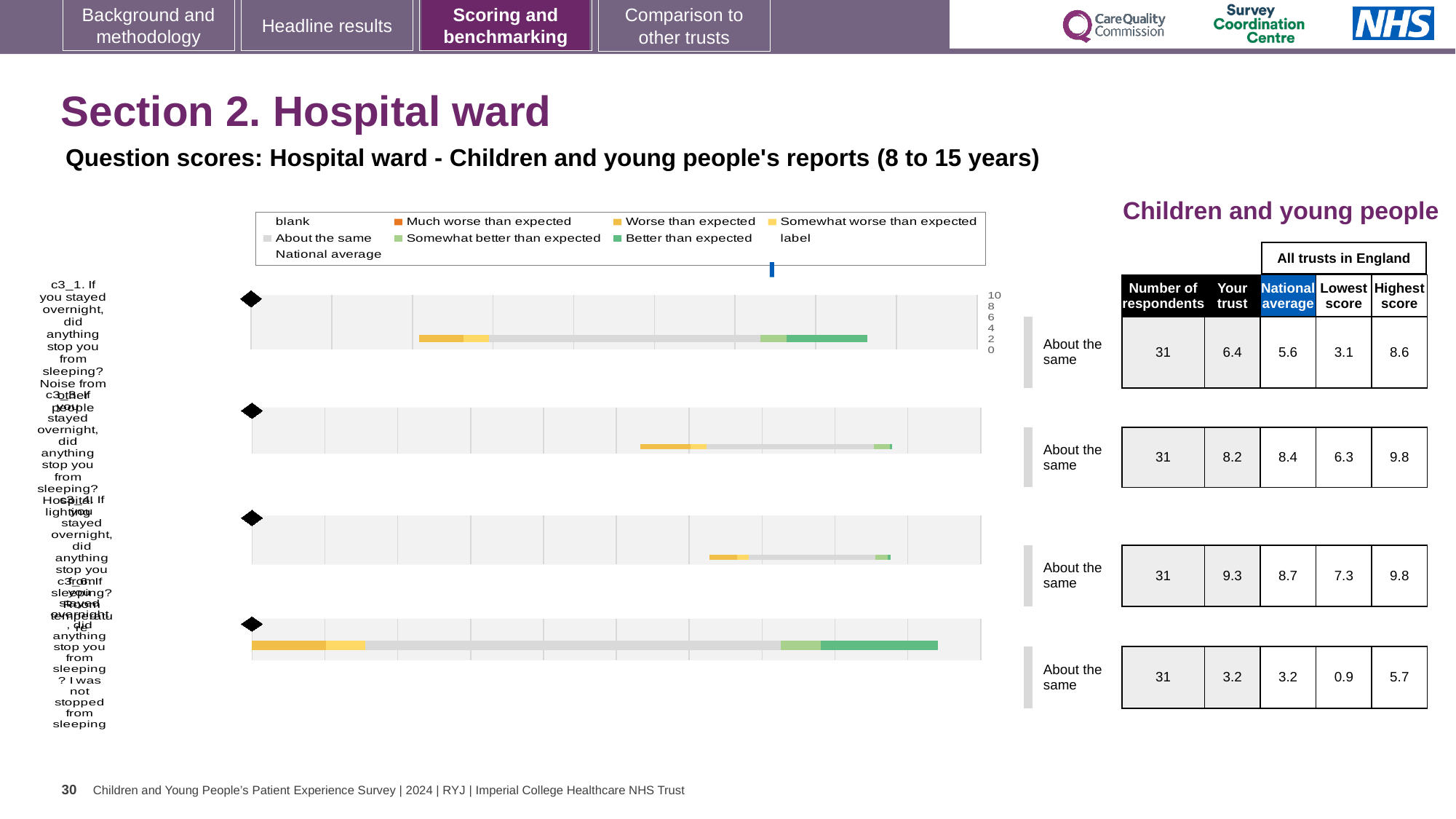
How many question charts are shown on the slide? 4 What is the maximum value shown on the score axis of the charts? 10 For the top chart, what is the difference between the 'Your trust' score and the national average? 0.8 How many respondents are reported for the second chart? 31 Which chart has the lowest 'Your trust' score? the fourth (bottom) chart (3.2) What kind of chart is used to show the question scores on this slide? bar chart In the legend, which colour represents 'Better than expected'? green For the top chart, what is the national average score? 5.6 For the top chart, what is the 'Your trust' score? 6.4 Which chart has the highest 'Your trust' score? the third chart (9.3) For the third chart, what is the highest score among all trusts in England? 9.8 For the top chart, which is larger: the 'Your trust' score or the national average? Your trust